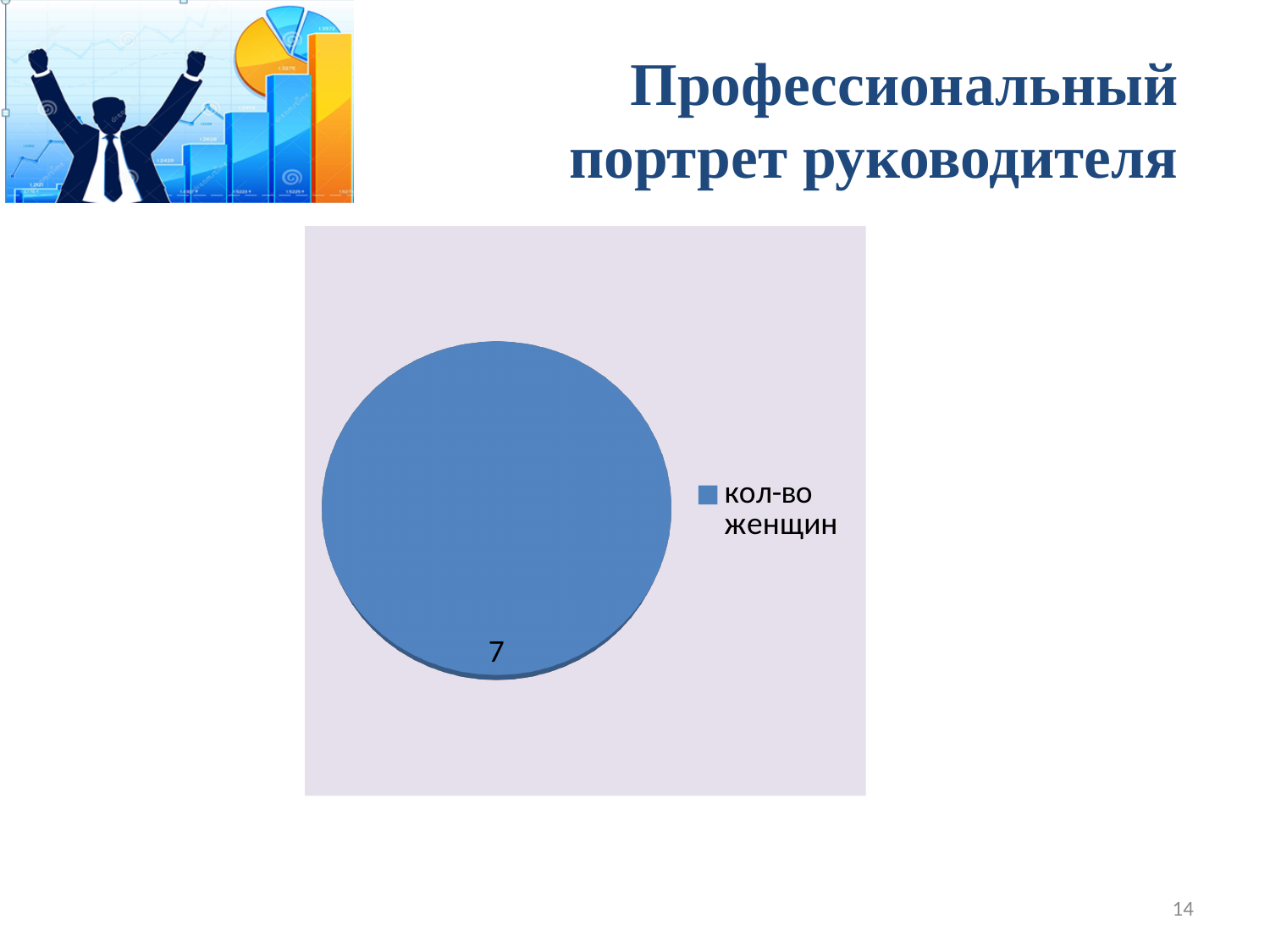
What is the legend entry of the pie chart? кол-во женщин What kind of chart is shown on the slide? pie chart What share of the pie does the кол-во женщин slice take? 100% How many entries does the legend list? 1 What colour is the pie slice? blue What value is printed on the pie slice? 7 What is the value for кол-во женщин? 7 How many slices does the pie chart have? 1